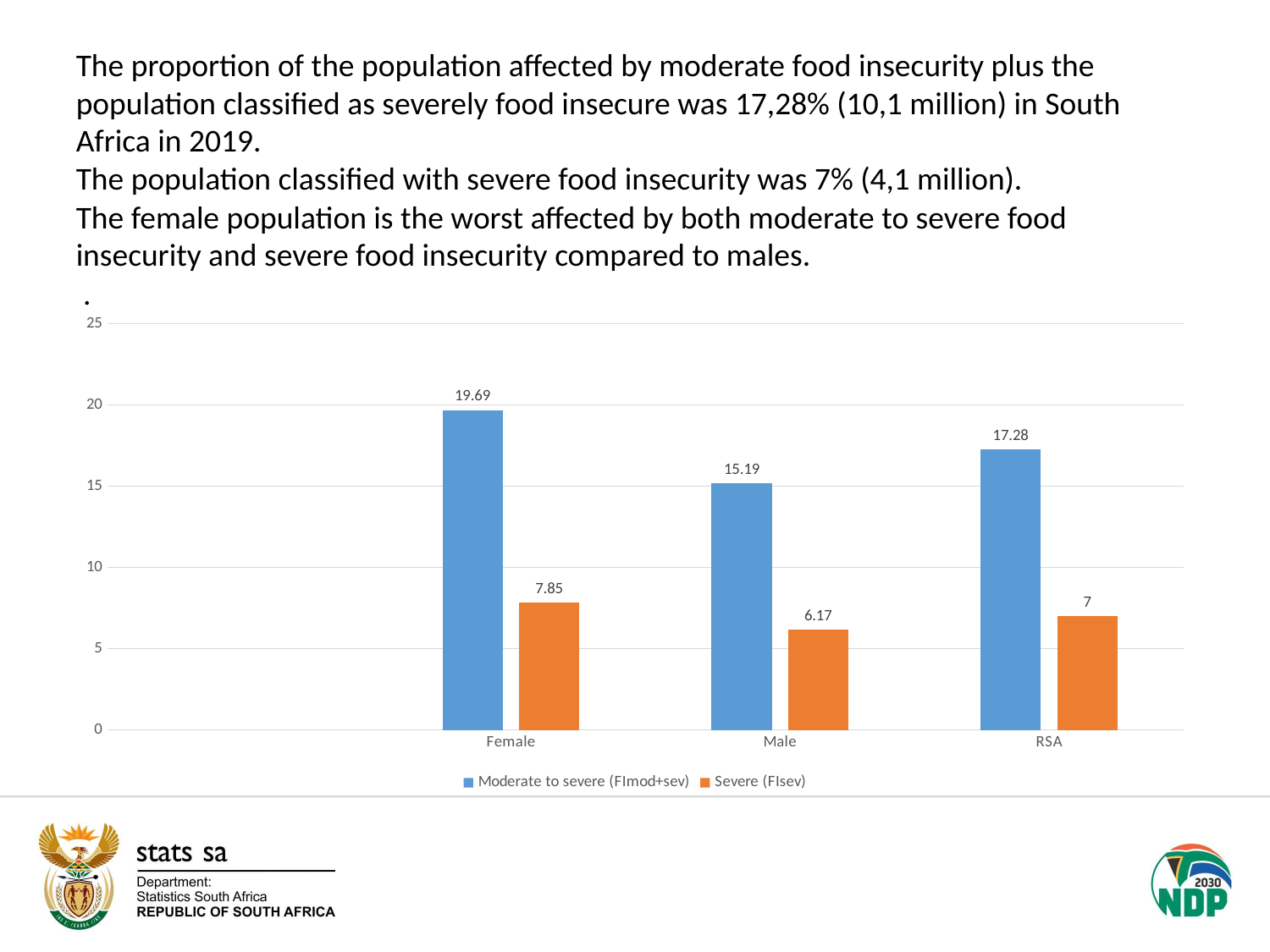
What is the Moderate to severe (FImod+sev) value for RSA? 17.28 Which category has the highest Moderate to severe (FImod+sev) value? Female What is the difference between the Moderate to severe (FImod+sev) values for Female and Male? 4.5 How many categories are shown on the x axis? 3 What is the Severe (FIsev) value for Male? 6.17 Which category has the lowest Severe (FIsev) value? Male What kind of chart is shown on the slide? bar chart How many series does the legend list? 2 What is the Moderate to severe (FImod+sev) value for Female? 19.69 What is the Severe (FIsev) value for RSA? 7 Which is larger, the Severe (FIsev) value for Female or for RSA? Female Is the Moderate to severe (FImod+sev) value for Male greater or less than 20? less